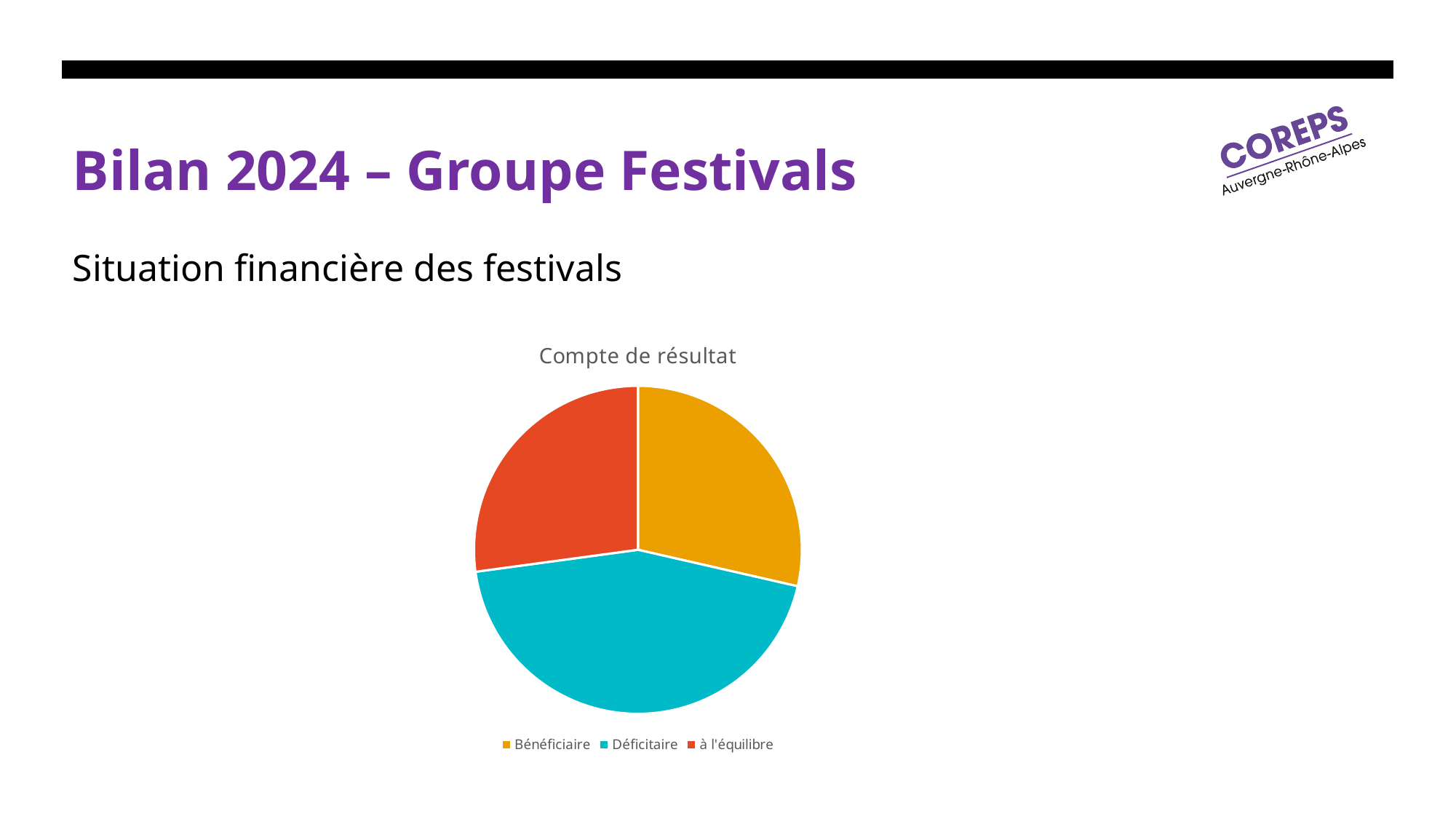
Which slice is larger, Déficitaire or Bénéficiaire? Déficitaire Which slice is larger, Déficitaire or à l'équilibre? Déficitaire How many slices does the pie chart have? 3 What kind of chart is shown on the slide? pie chart How many entries does the chart legend list? 3 What is the title of the chart? Compte de résultat Which colour represents the Déficitaire category in the pie chart? teal (blue-green) Which category has the largest slice of the pie? Déficitaire